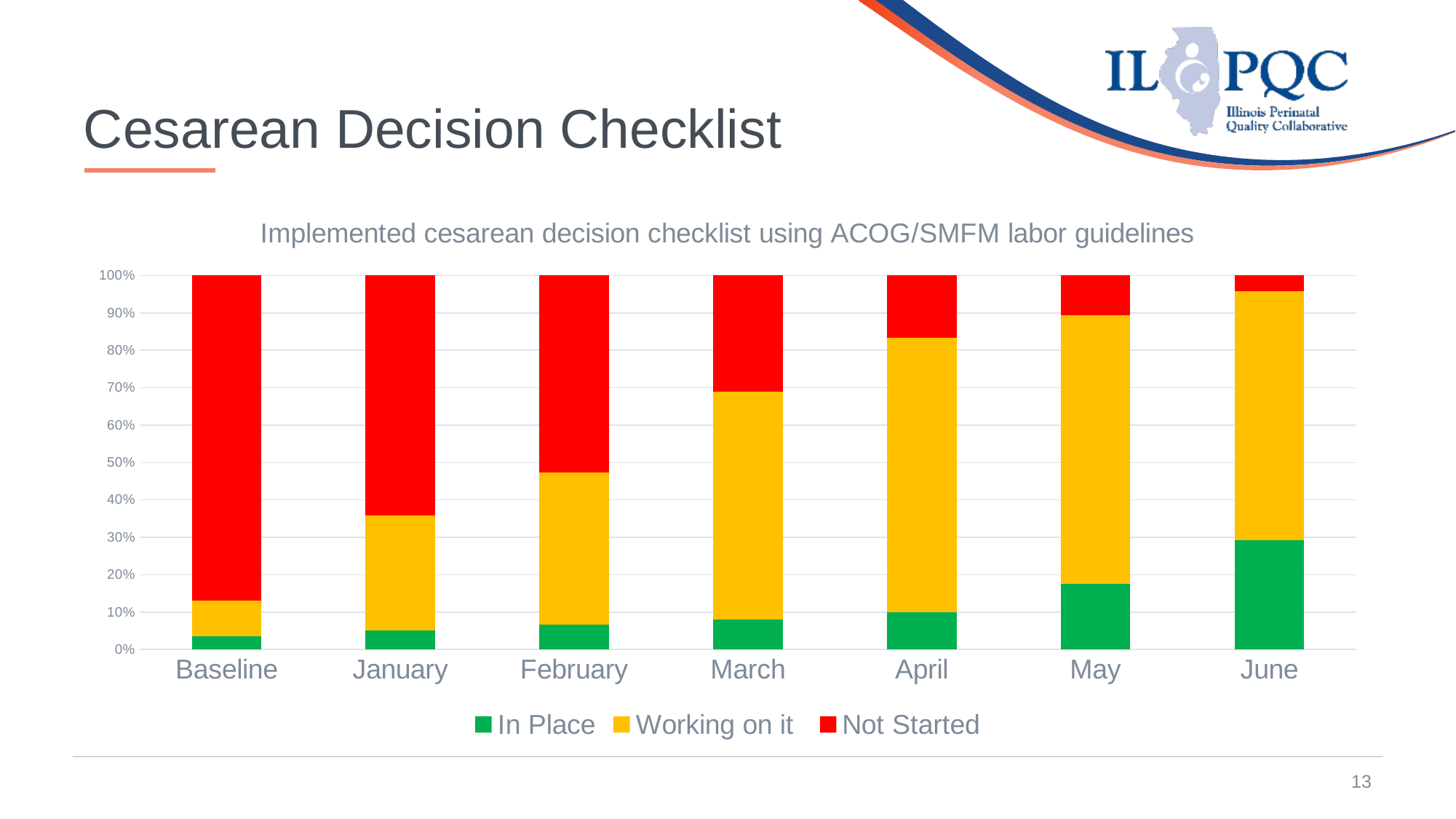
Does the In Place share rise or fall from Baseline to June? Rise What kind of chart is shown on the slide? Stacked bar chart Which has the larger Not Started share, January or March? January Which category has the largest Not Started share? Baseline How many series does the legend list? 3 Which category has the smallest Not Started share? June What is the title of the chart? Implemented cesarean decision checklist using ACOG/SMFM labor guidelines Is the Not Started value for Baseline greater or less than 80%? greater Is the In Place value for June greater or less than 20%? greater How many categories are shown along the x axis? 7 Which category has the largest In Place share? June Is the Working on it value for March greater or less than 50%? greater